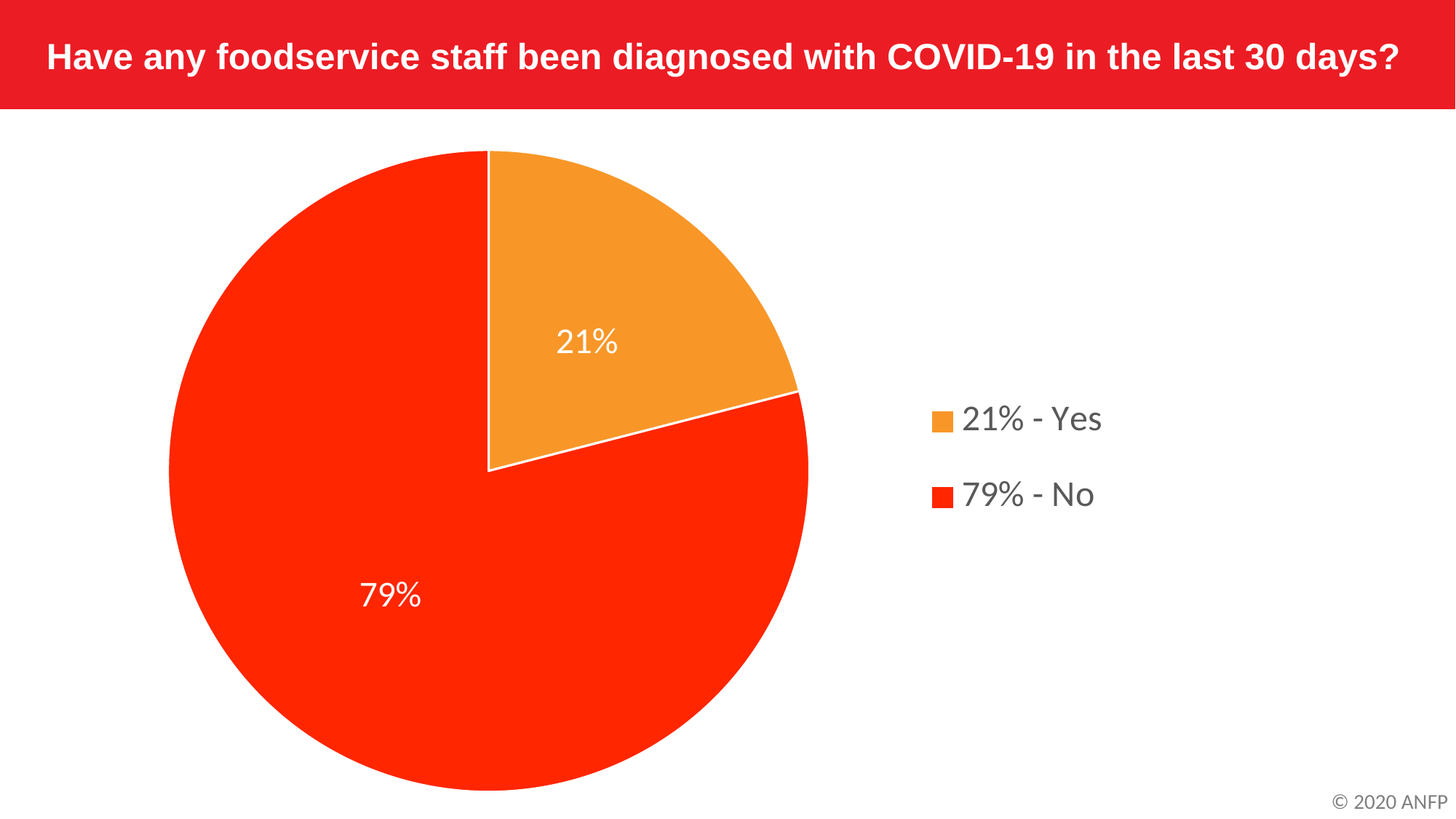
Which response has the smallest share of the pie? Yes What percentage of respondents answered Yes? 21% What share of the pie does the Yes slice represent? 21% Which response has the largest share of the pie? No What kind of chart is shown on the slide? pie chart What question does the chart title ask? Have any foodservice staff been diagnosed with COVID-19 in the last 30 days? How many entries does the legend list? 2 What percentage of respondents answered No? 79% How many slices does the pie chart have? 2 What is the difference in percentage points between the No and Yes slices? 58 Which is larger, the Yes slice or the No slice? No What colour is the No slice? red